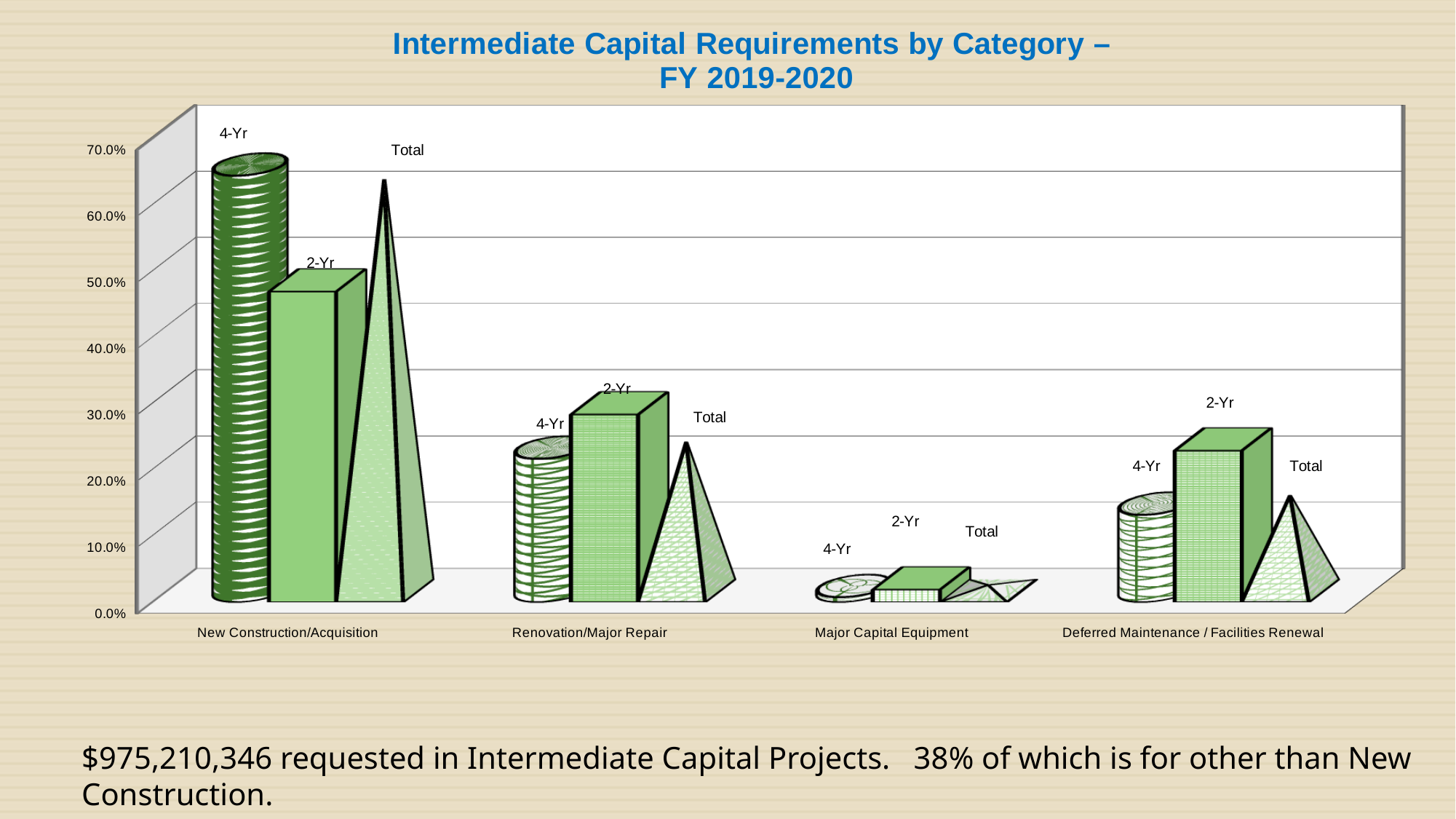
What type of chart is shown on the slide? Bar chart Is the 4-Yr value for Major Capital Equipment greater or less than 10.0%? less Is the 4-Yr value for New Construction/Acquisition greater or less than 60.0%? greater How many series (4-Yr, 2-Yr, Total) are plotted for each category? 3 For Renovation/Major Repair, which is larger, the 4-Yr value or the 2-Yr value? 2-Yr Is the 4-Yr value for Deferred Maintenance / Facilities Renewal greater or less than 20.0%? less Which category has the highest 4-Yr value? New Construction/Acquisition How many categories are shown on the x axis of the chart? 4 What is the title of the chart? Intermediate Capital Requirements by Category – FY 2019-2020 For New Construction/Acquisition, which is larger, the 4-Yr value or the 2-Yr value? 4-Yr Which category has the lowest Total value? Major Capital Equipment